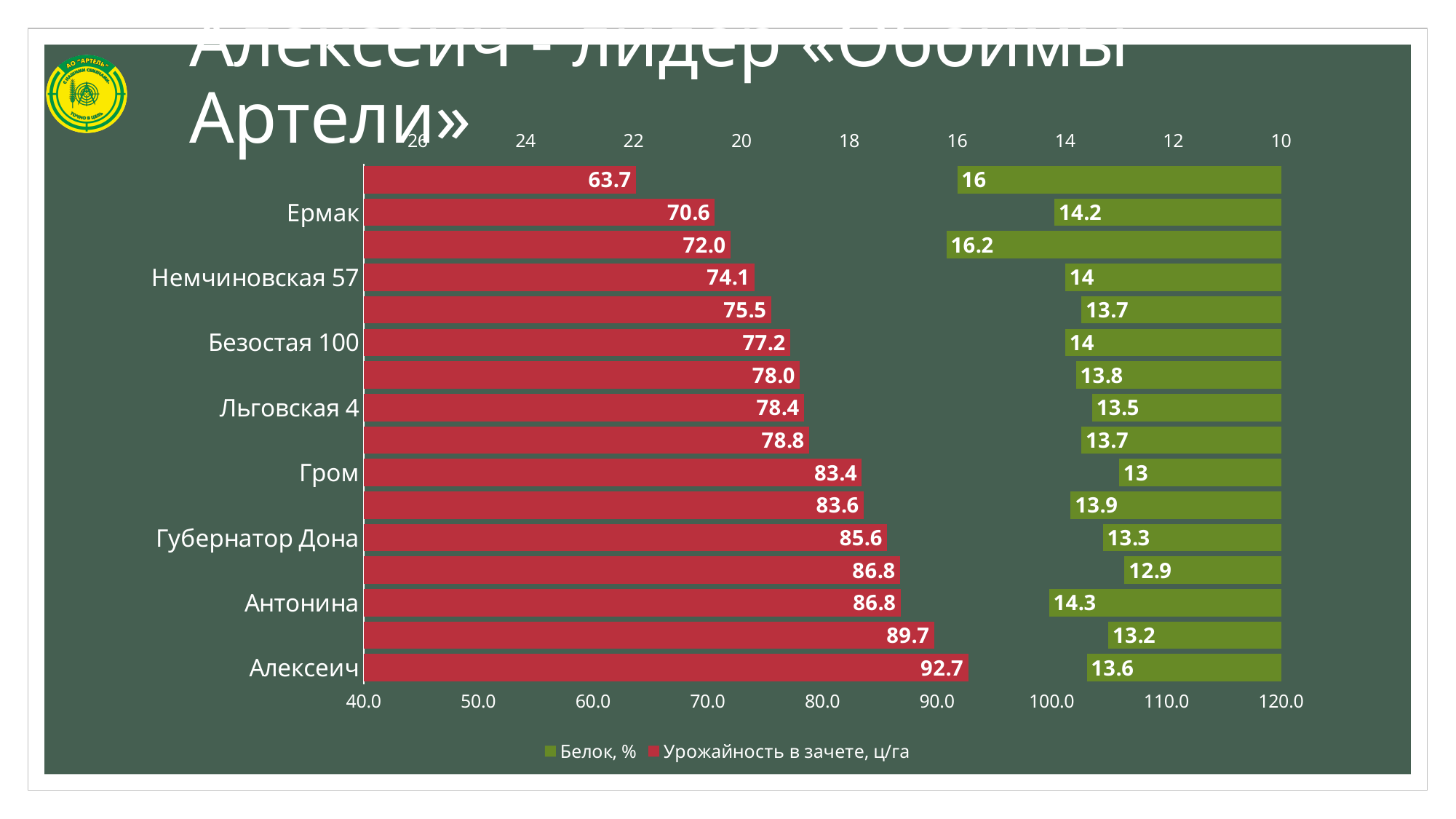
What is the difference in yield (Урожайность в зачете, ц/га) between Алексеич and Ермак? 22.1 Is the yield (Урожайность в зачете, ц/га) for Алексеич greater or less than 90.0? greater Do the yield (Урожайность в зачете, ц/га) values rise or fall going down the list from the top bar to Алексеич? rise Which has the higher protein (Белок, %) value: Ермак or Льговская 4? Ермак How many series does the legend list? 2 What kind of chart is shown on the slide? bar chart What is the protein (Белок, %) value for Антонина? 14.3 Which has the higher yield (Урожайность в зачете, ц/га): Гром or Губернатор Дона? Губернатор Дона What is the protein (Белок, %) value for Гром? 13 What is the yield (Урожайность в зачете, ц/га) value for Алексеич? 92.7 What is the yield (Урожайность в зачете, ц/га) value for Ермак? 70.6 Which variety has the highest yield (Урожайность в зачете, ц/га)? Алексеич